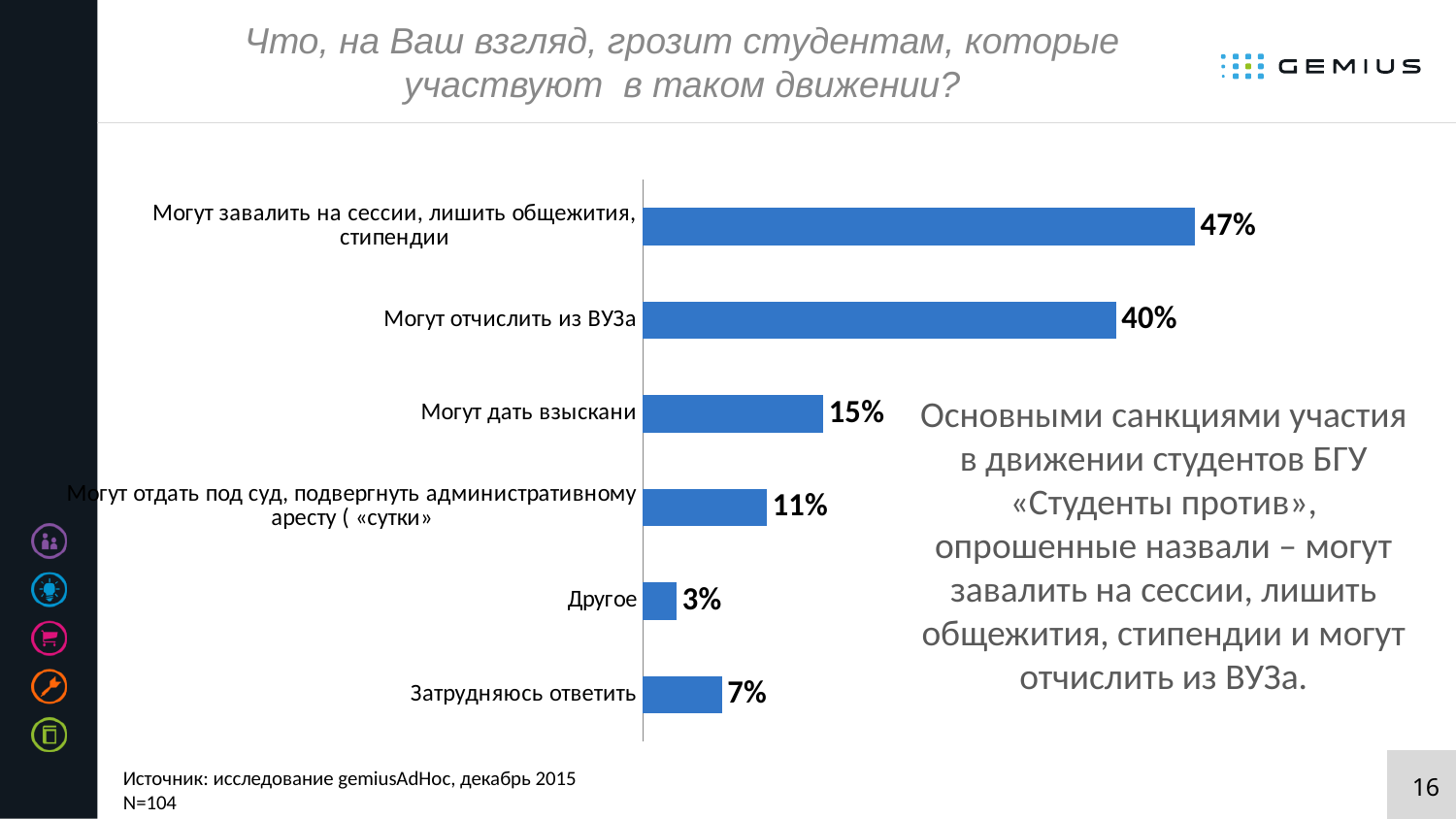
What kind of chart is shown on the slide? Bar chart What is the value for "Могут отчислить из ВУЗа"? 40% What is the difference between the values for "Могут завалить на сессии, лишить общежития, стипендии" and "Могут отчислить из ВУЗа"? 7% Which category has the highest value? Могут завалить на сессии, лишить общежития, стипендии What is the value for "Другое"? 3% What is the value for "Затрудняюсь ответить"? 7% What is the difference between the values for "Затрудняюсь ответить" and "Другое"? 4% Which is larger: the value for "Могут дать взыскани" or the value for "Могут отдать под суд, подвергнуть административному аресту ( «сутки»"? Могут дать взыскани What is the sample size (N) stated on the slide? N=104 Which category has the lowest value? Другое How many categories are shown in the chart? 6 What is the value for "Могут дать взыскани"? 15%